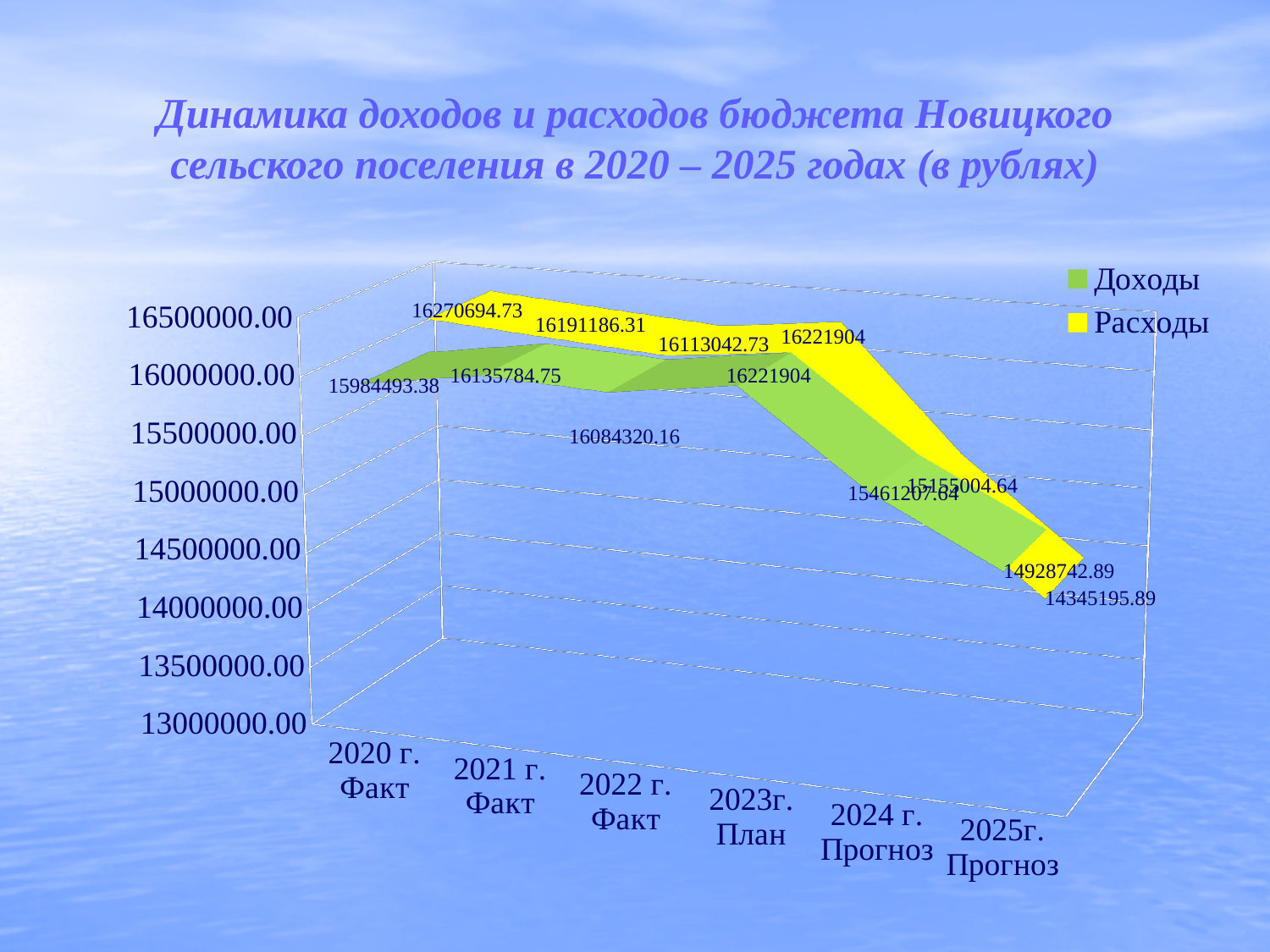
In which category is Расходы highest? 2020 г. Факт Do the Расходы values rise or fall from 2023г. План to 2025г. Прогноз? fall In which category is Доходы lowest? 2025г. Прогноз How many series does the legend list? 2 What is the value of Расходы for 2025г. Прогноз? 14345195.89 What is the value of Доходы for 2020 г. Факт? 15984493.38 How many categories are shown on the x axis? 6 What is the difference between Доходы and Расходы for 2025г. Прогноз? 583547 For 2020 г. Факт, which is larger: Доходы or Расходы? Расходы What is the value of Доходы for 2025г. Прогноз? 14928742.89 What is the value of Расходы for 2020 г. Факт? 16270694.73 What is the value of Доходы for 2023г. План? 16221904